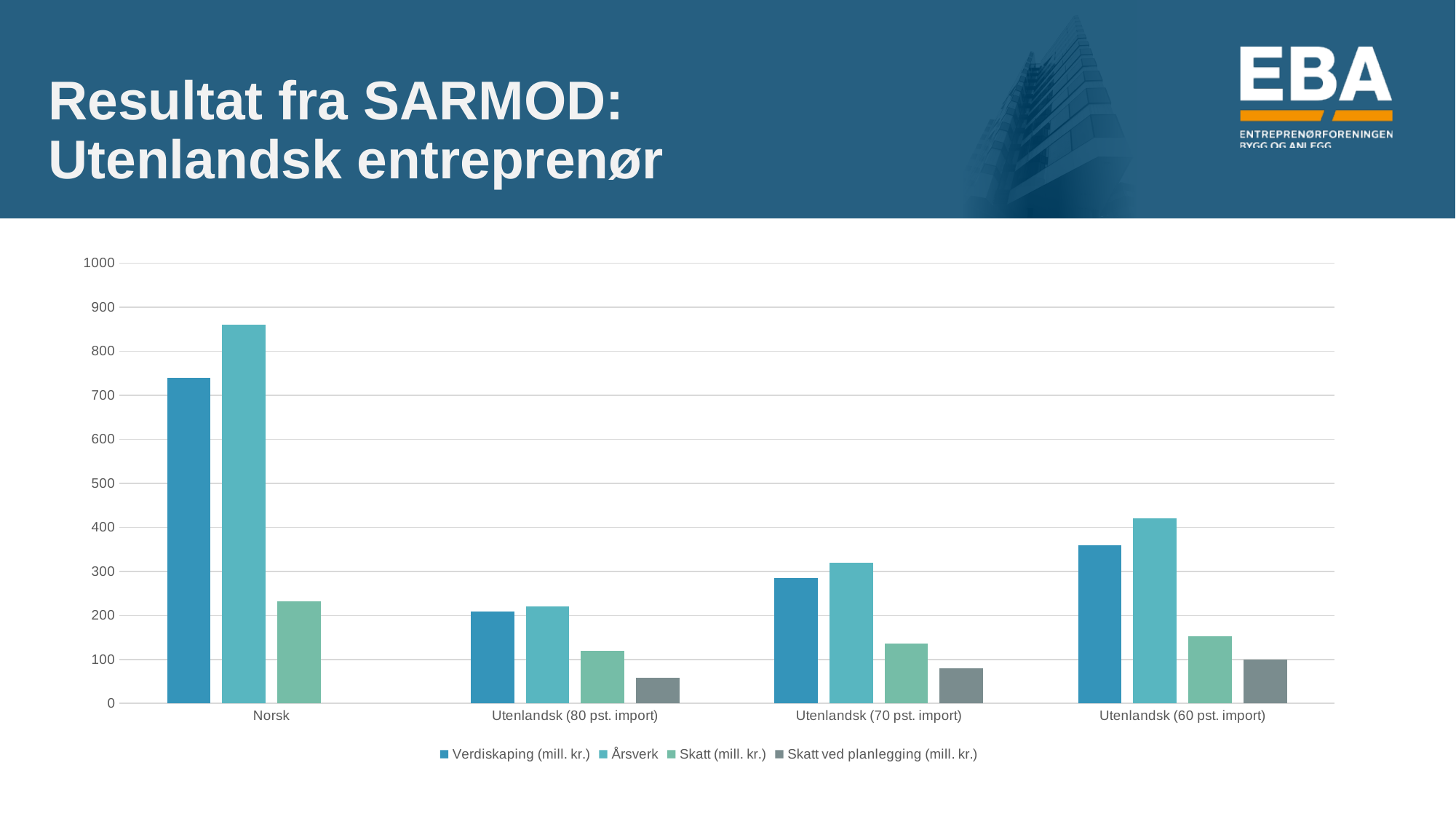
What kind of chart is shown on the slide? bar chart Across the three Utenlandsk categories from left to right, do the Verdiskaping (mill. kr.) values rise or fall? rise Which series is shown in dark grey in the legend? Skatt ved planlegging (mill. kr.) Is the Årsverk value for Norsk greater or less than 800? greater Is the Skatt ved planlegging (mill. kr.) value for Utenlandsk (80 pst. import) greater or less than 100? less Which has the larger Verdiskaping (mill. kr.) value: Utenlandsk (70 pst. import) or Utenlandsk (60 pst. import)? Utenlandsk (60 pst. import) Which category has the highest value for Årsverk? Norsk Is the Årsverk value for Utenlandsk (60 pst. import) greater or less than 400? greater How many series does the legend list? 4 How many categories are shown on the x axis of the chart? 4 Which category has the lowest value for Verdiskaping (mill. kr.)? Utenlandsk (80 pst. import)